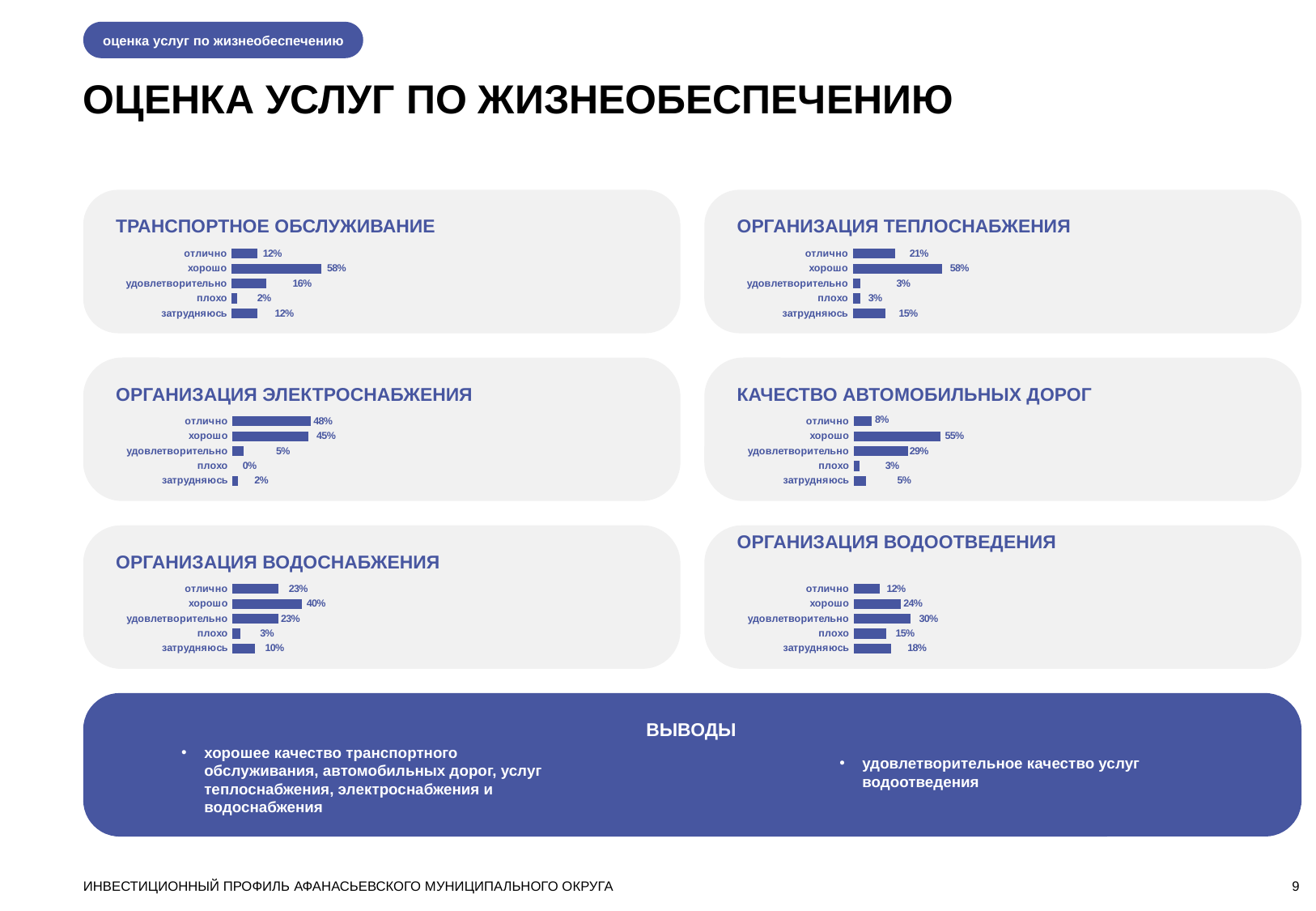
What kind of chart is the one titled ОРГАНИЗАЦИЯ ТЕПЛОСНАБЖЕНИЯ? bar chart In the chart titled ОРГАНИЗАЦИЯ ТЕПЛОСНАБЖЕНИЯ, what is the value for отлично? 21% How many categories does the chart titled ТРАНСПОРТНОЕ ОБСЛУЖИВАНИЕ show? 5 In the chart titled ОРГАНИЗАЦИЯ ВОДОСНАБЖЕНИЯ, what is the difference between хорошо and затрудняюсь? 30% In the chart titled ТРАНСПОРТНОЕ ОБСЛУЖИВАНИЕ, what is the value for хорошо? 58% In the chart titled ОРГАНИЗАЦИЯ ВОДООТВЕДЕНИЯ, what is the value for плохо? 15% In the chart titled КАЧЕСТВО АВТОМОБИЛЬНЫХ ДОРОГ, what is the difference between хорошо and удовлетворительно? 26% How many charts are shown on the slide? 6 In the chart titled ОРГАНИЗАЦИЯ ЭЛЕКТРОСНАБЖЕНИЯ, which category has the highest value? отлично In the chart titled ОРГАНИЗАЦИЯ ВОДОСНАБЖЕНИЯ, which is larger: хорошо or отлично? хорошо In the chart titled ОРГАНИЗАЦИЯ ВОДООТВЕДЕНИЯ, which category has the highest value? удовлетворительно In the chart titled ОРГАНИЗАЦИЯ ЭЛЕКТРОСНАБЖЕНИЯ, which category has the lowest value? плохо